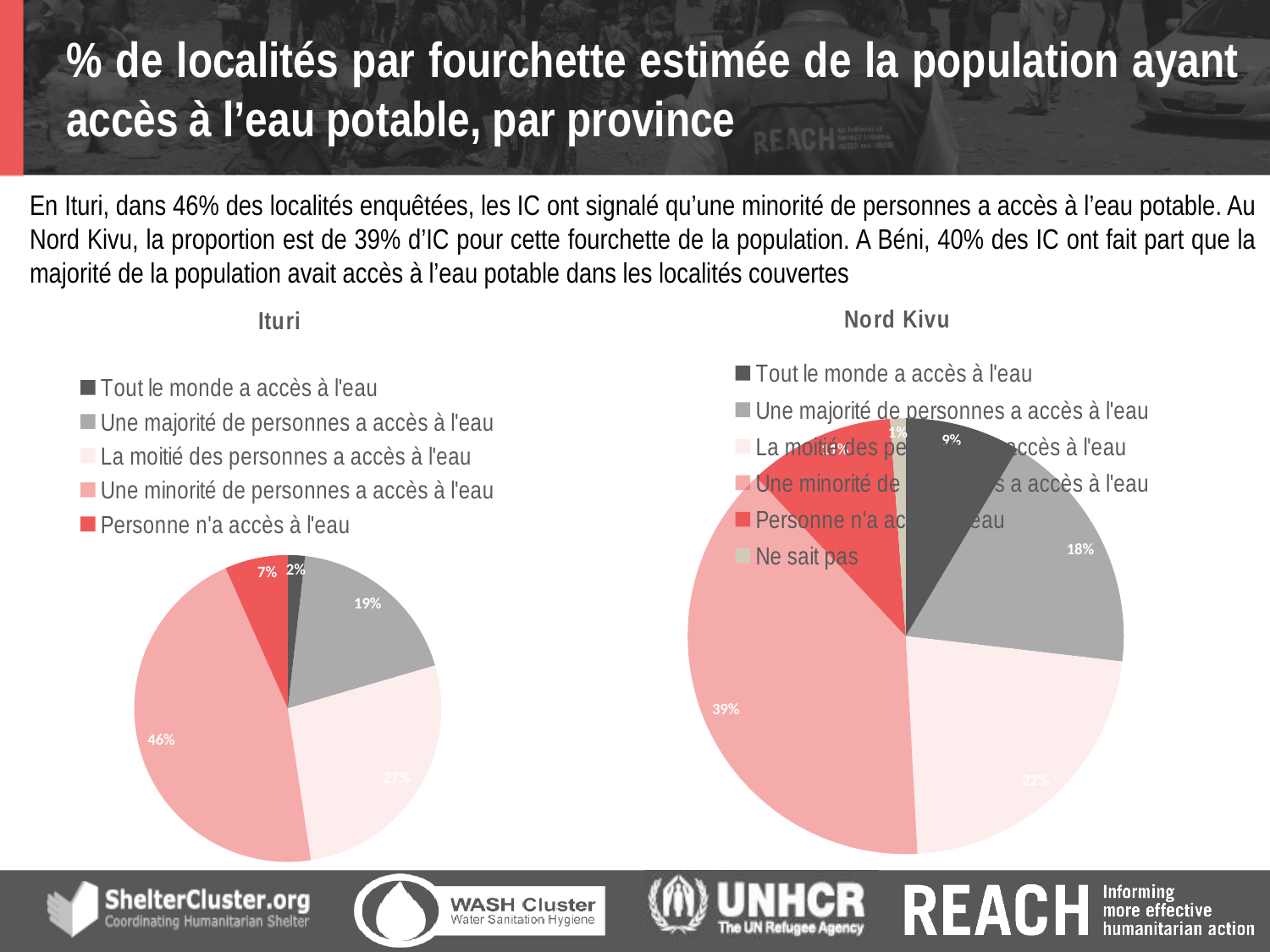
In the Ituri pie chart, what is the difference in percentage points between 'Une minorité de personnes a accès à l'eau' and 'La moitié des personnes a accès à l'eau'? 19 percentage points Which province has the larger share for 'Tout le monde a accès à l'eau', Ituri or Nord Kivu? Nord Kivu In the Nord Kivu pie chart, what percentage corresponds to 'Une majorité de personnes a accès à l'eau'? 18% What type of chart is used for the Ituri and Nord Kivu data? Pie chart How many categories does the legend of the Nord Kivu pie chart list? 6 How many categories does the legend of the Ituri pie chart list? 5 In the Ituri pie chart, which category has the largest share? Une minorité de personnes a accès à l'eau In the Ituri pie chart, what percentage of localities reported that a minority of people have access to water (Une minorité de personnes a accès à l'eau)? 46% In the Ituri pie chart, what percentage corresponds to 'Personne n'a accès à l'eau'? 7% In the Nord Kivu pie chart, what percentage corresponds to 'La moitié des personnes a accès à l'eau'? 22% In the Ituri pie chart, which category has the smallest share? Tout le monde a accès à l'eau In the Nord Kivu pie chart, what percentage corresponds to 'Une minorité de personnes a accès à l'eau'? 39%